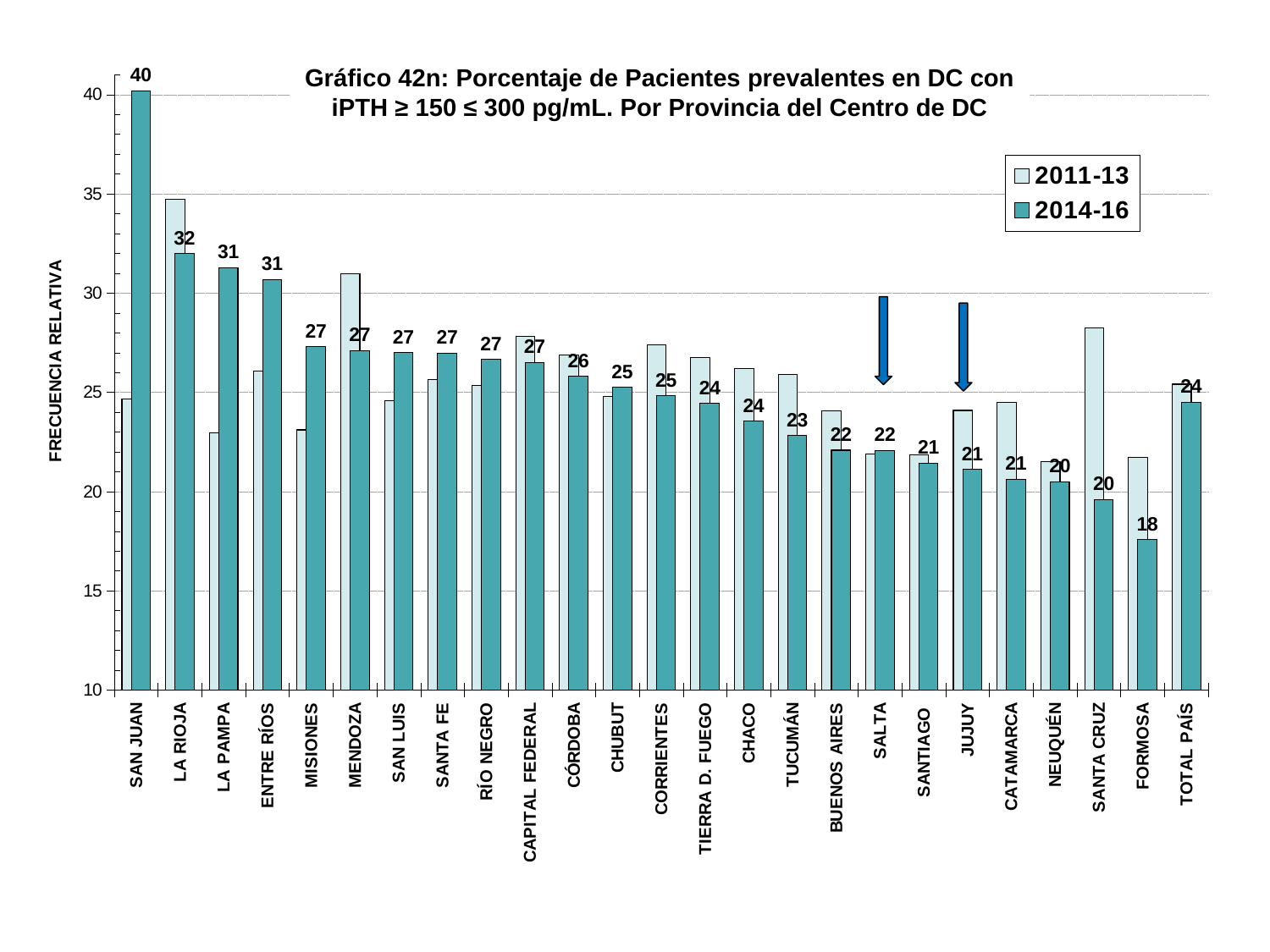
Is the 2011-13 value for MENDOZA greater or less than 30? greater What is the 2014-16 value for SAN JUAN? 40 Which province has the lowest 2014-16 value? FORMOSA Which province has the highest 2014-16 value? SAN JUAN What is the 2014-16 value for TOTAL PAÍS? 24 How many series does the legend list? 2 How many categories are shown on the x axis? 25 Is the 2011-13 value for SAN JUAN greater or less than 25? less Which has the larger 2014-16 value, LA RIOJA or CHACO? LA RIOJA What kind of chart is this? bar chart What is the 2014-16 value for FORMOSA? 18 What is the difference between the 2014-16 values for SAN JUAN and FORMOSA? 22